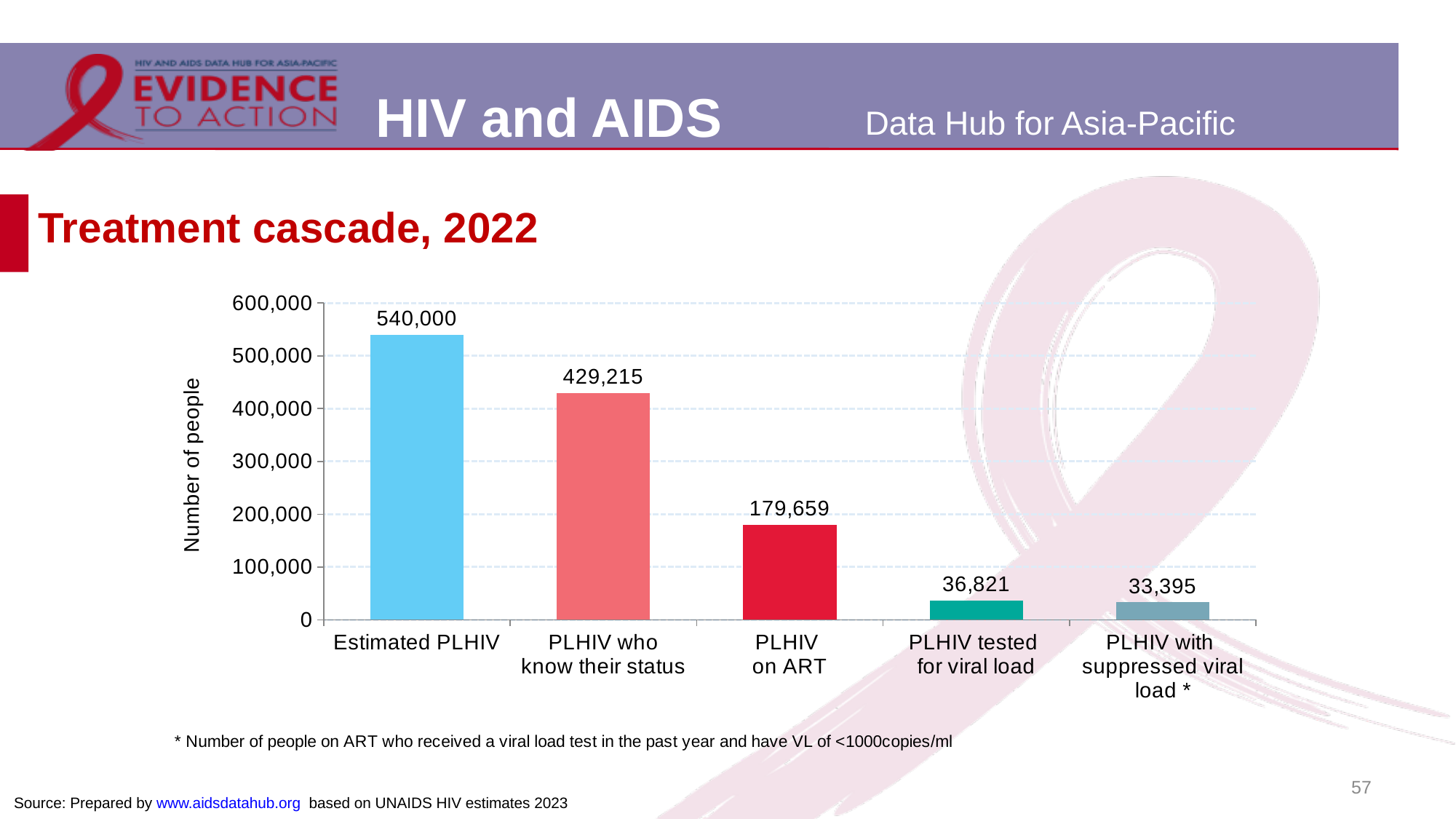
What is the difference between PLHIV tested for viral load and PLHIV with suppressed viral load? 3,426 How many categories are shown in the chart? 5 What is the value for PLHIV tested for viral load? 36,821 Which is larger, PLHIV who know their status or PLHIV on ART? PLHIV who know their status Which category has the lowest value? PLHIV with suppressed viral load What kind of chart is shown on the slide? Bar chart What is the value for PLHIV with suppressed viral load? 33,395 What is the value for PLHIV who know their status? 429,215 What is the difference between Estimated PLHIV and PLHIV who know their status? 110,785 Which category has the highest value? Estimated PLHIV What is the value for Estimated PLHIV? 540,000 What is the value for PLHIV on ART? 179,659